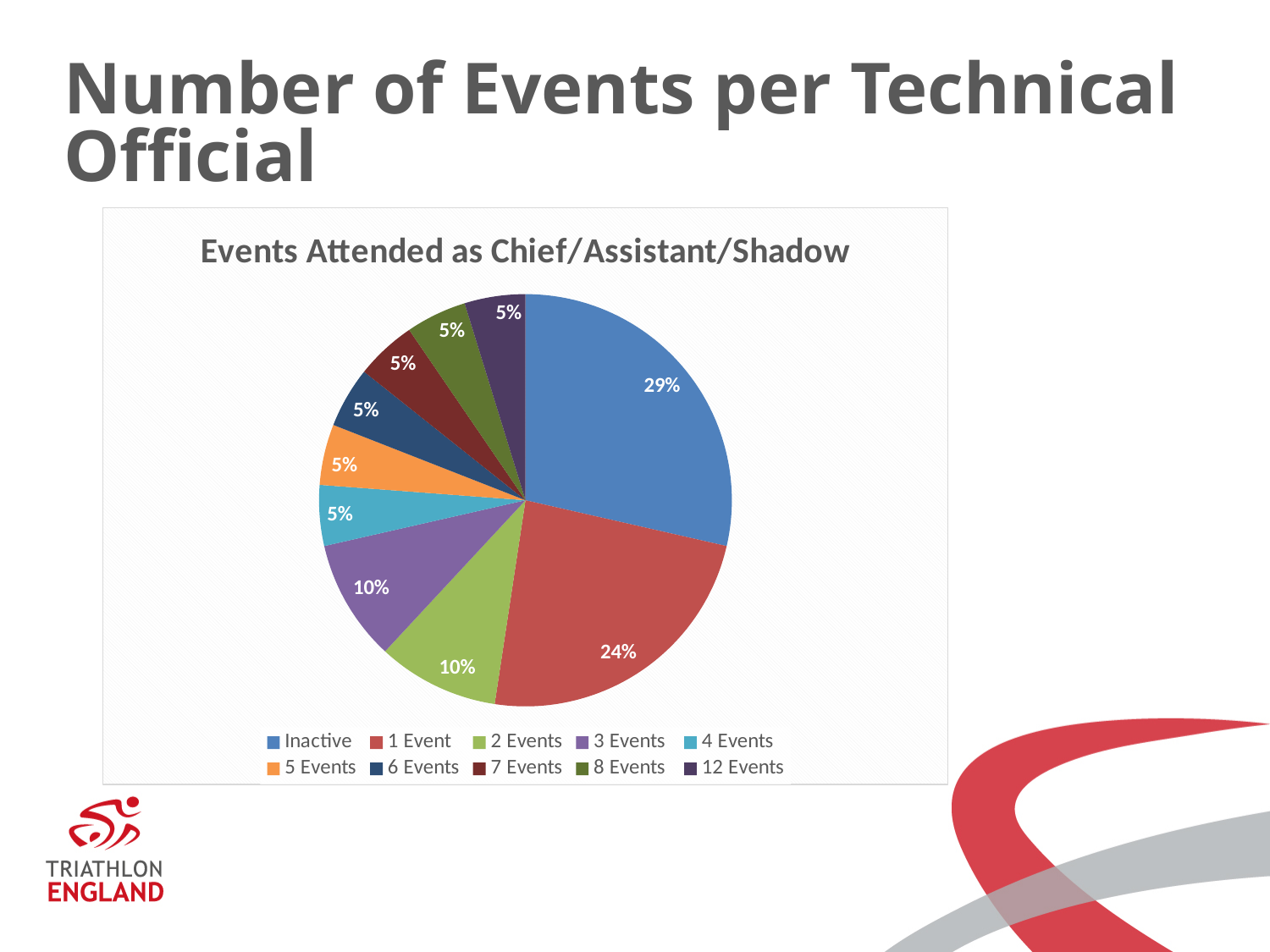
What percentage of technical officials attended 1 Event? 24% Which category has the largest slice of the pie? Inactive Which is larger, the slice for 1 Event or the slice for 2 Events? 1 Event What percentage is shown for 3 Events? 10% How many categories does the legend list? 10 What is the title of the chart? Events Attended as Chief/Assistant/Shadow What is the difference in percentage points between the Inactive slice and the 1 Event slice? 5 What percentage is shown for 12 Events? 5% What share of the pie is labelled Inactive? 29% What is the difference in percentage points between the 2 Events slice and the 4 Events slice? 5 What colour is the Inactive slice? Blue What type of chart is shown on the slide? Pie chart